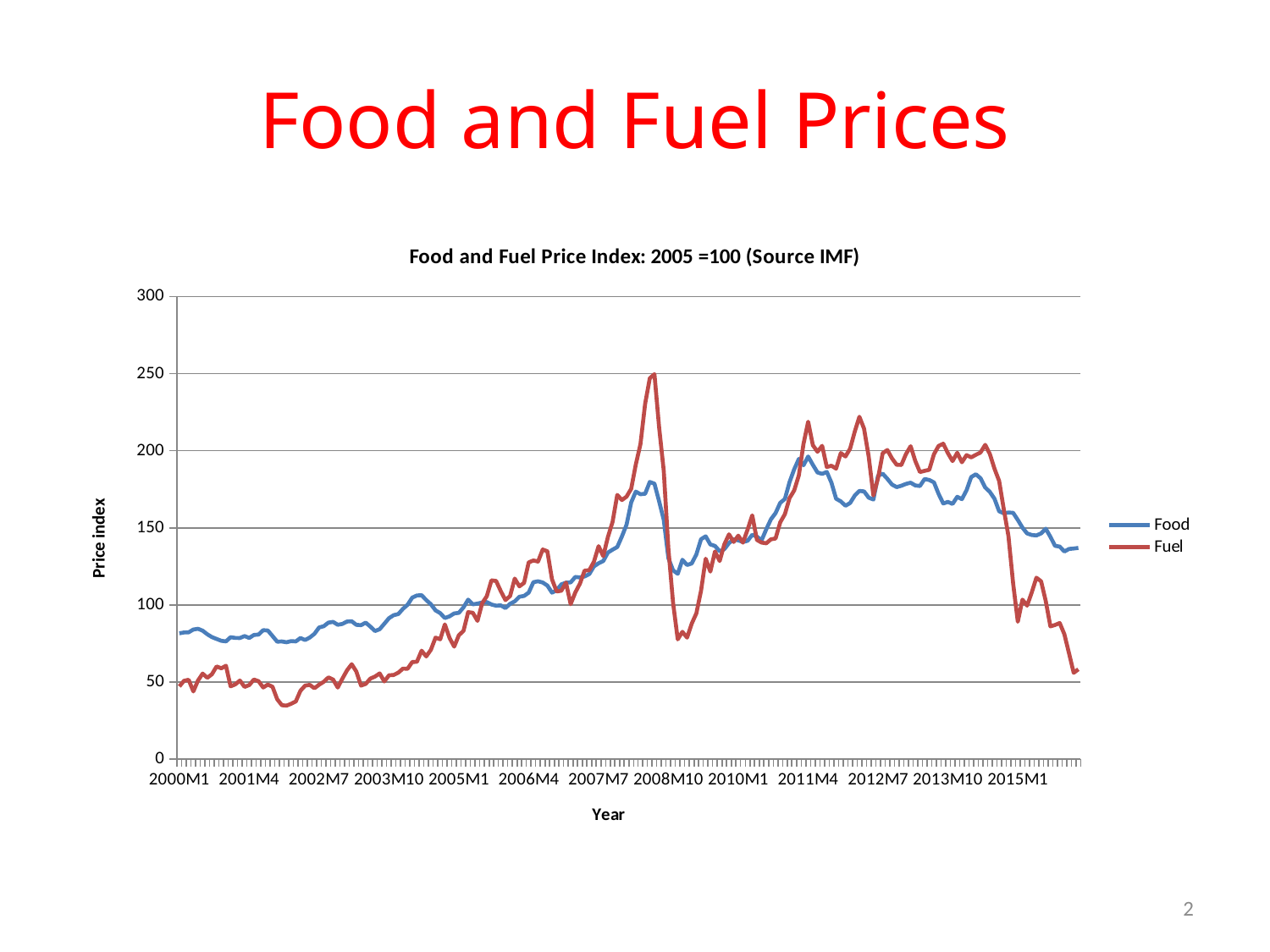
What kind of chart is shown on the slide? line chart Which series reaches the highest peak on the chart? Fuel Is the value for Food at 2011M4 greater or less than 150? greater Is the value for Food at 2000M1 greater or less than 100? less What colour is the Fuel line? red Is the value for Fuel at 2006M4 greater or less than 100? greater How many series does the legend list? 2 At the end of the series (right edge of the chart), which series has the higher value, Food or Fuel? Food What is the title of the chart? Food and Fuel Price Index: 2005 =100 (Source IMF) At 2000M1, which series has the higher value, Food or Fuel? Food Does the Fuel line generally rise or fall between 2000M1 and 2007M7? rise